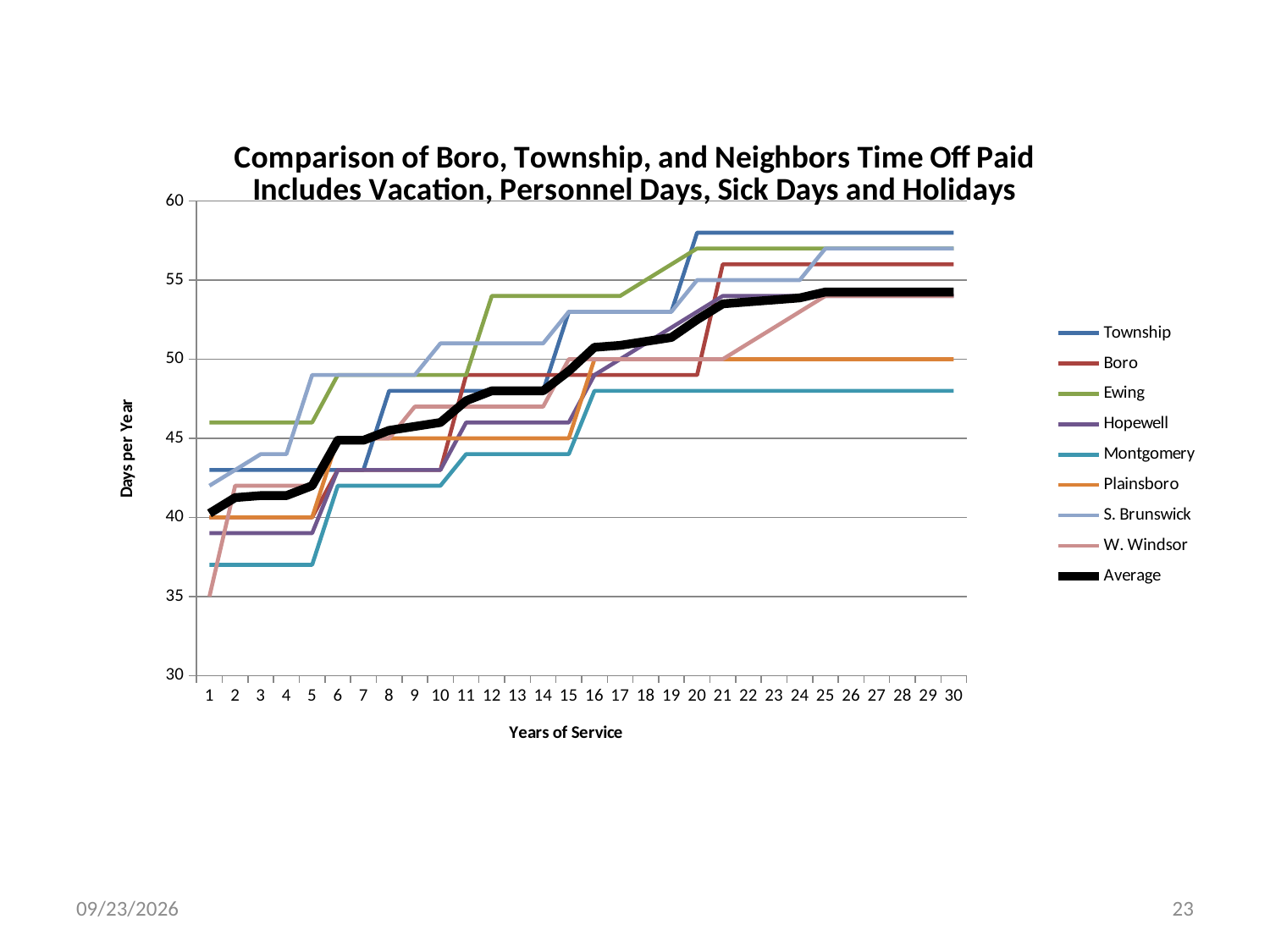
What is the label on the y axis? Days per Year What is the value for Plainsboro at 30 years of service? 50 What is the value for W. Windsor at 1 year of service? 35 Which series has the lowest value at 1 year of service? W. Windsor Is the value for Montgomery at 1 year of service greater or less than 40? less How many years of service are shown along the x axis? 30 Which series has the highest value at 1 year of service? Ewing Which series has the lowest value at 30 years of service? Montgomery Is the value for Township at 30 years of service greater or less than 55? greater What kind of chart is shown on the slide? line chart Do the values for the Average series rise or fall as years of service increase? rise How many series does the legend list? 9